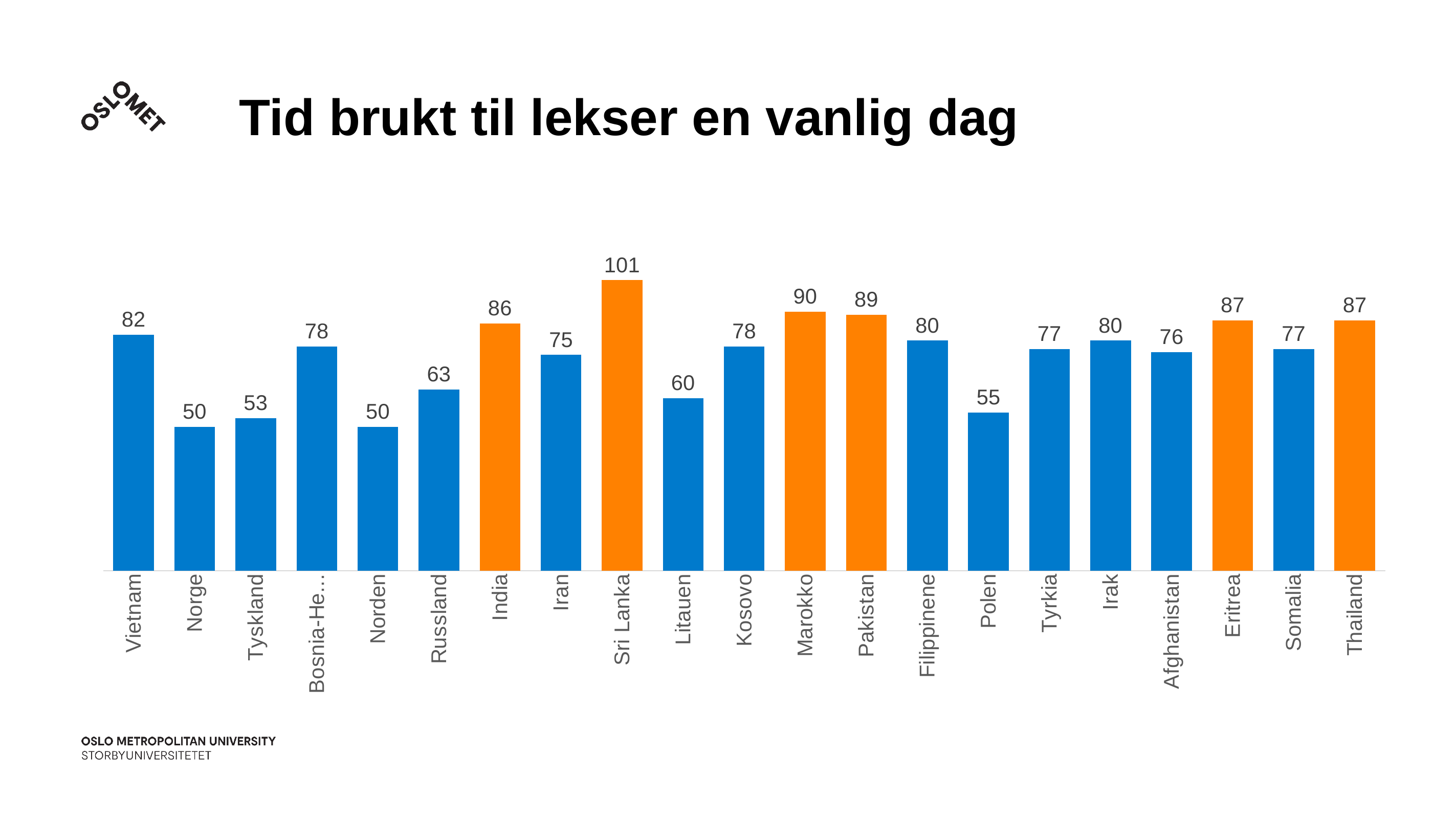
How many countries are shown in the chart? 21 What kind of chart is shown on the slide? Bar chart What is the value for Sri Lanka? 101 What is the value for Afghanistan? 76 Which country has the highest value? Sri Lanka What is the difference between the values for Sri Lanka and Vietnam? 19 What is the value for Norge? 50 Which is larger, the value for Russland or the value for Litauen? Russland Which is larger, the value for India or the value for Iran? India What is the title of the chart? Tid brukt til lekser en vanlig dag What is the difference between the values for Pakistan and Polen? 34 What is the value for Marokko? 90